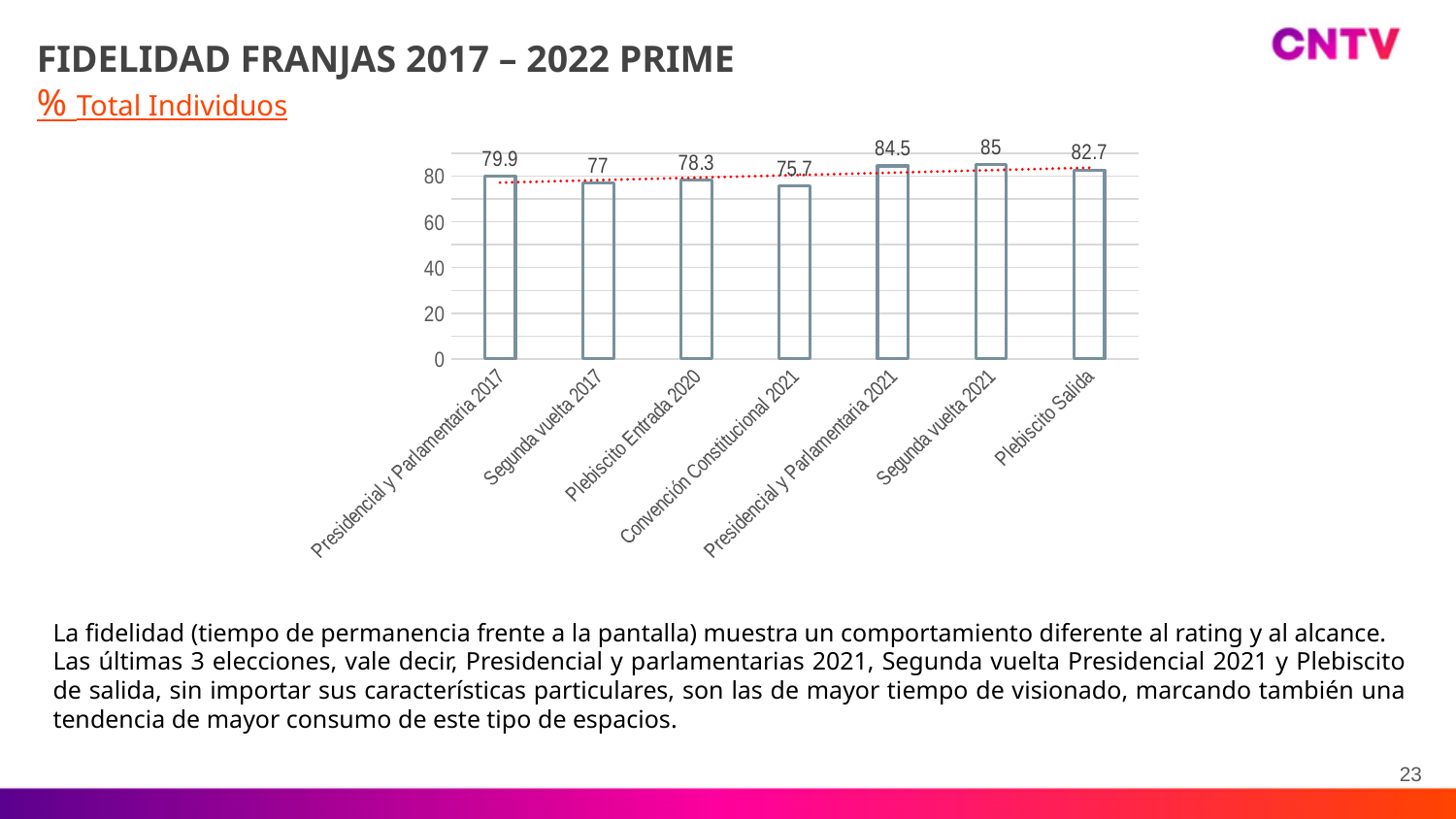
Which category has the lowest value? Convención Constitucional 2021 What is the difference between the values for Presidencial y Parlamentaria 2021 and Presidencial y Parlamentaria 2017? 4.6 What is the title of the slide above the chart? FIDELIDAD FRANJAS 2017 – 2022 PRIME How many categories are shown on the x axis? 7 Which is larger, the value for Plebiscito Entrada 2020 or the value for Segunda vuelta 2017? Plebiscito Entrada 2020 What is the value for Convención Constitucional 2021? 75.7 Which category has the highest value? Segunda vuelta 2021 What is the value for Plebiscito Entrada 2020? 78.3 What kind of chart is shown on the slide? Bar chart What is the value for Segunda vuelta 2017? 77 What is the value for Presidencial y Parlamentaria 2017? 79.9 What is the value for Plebiscito Salida? 82.7